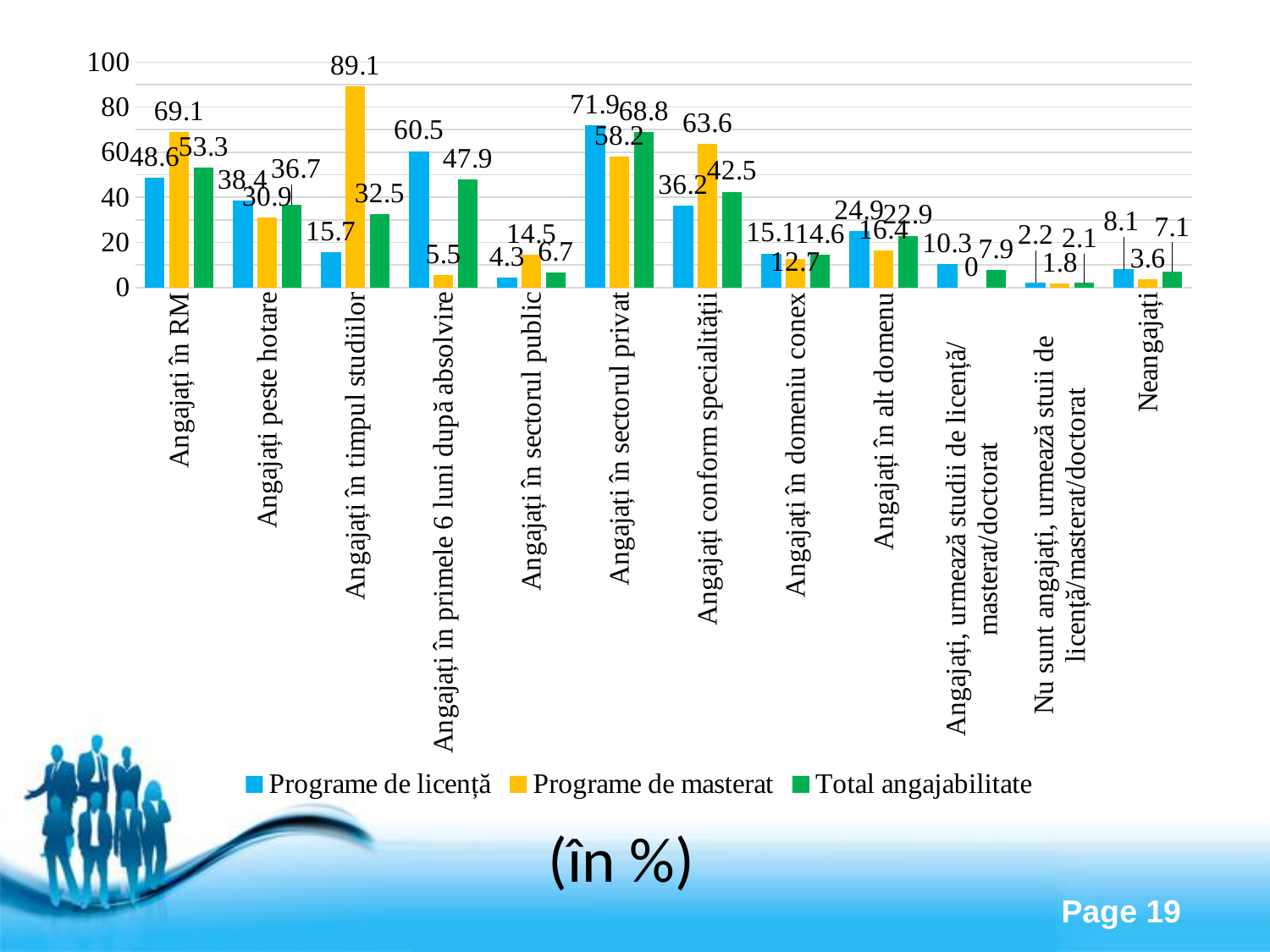
What kind of chart is shown on the slide? Bar chart Which category has the lowest value for Total angajabilitate? Nu sunt angajați, urmează stuii de licență/masterat/doctorat What is the value for Programe de licență in the category Angajați în sectorul privat? 71.9 What is the value for Programe de masterat in the category Angajați, urmează studii de licență/masterat/doctorat? 0 What is the value for Total angajabilitate in the category Angajați în RM? 53.3 What is the difference between Programe de masterat and Programe de licență in the category Angajați în RM? 20.5 Which category has the highest value for Programe de licență? Angajați în sectorul privat How many series does the legend list? 3 Which is larger in the category Angajați în primele 6 luni după absolvire: Programe de licență or Programe de masterat? Programe de licență What is the value for Programe de masterat in the category Angajați în timpul studiilor? 89.1 Which colour represents Total angajabilitate in the legend? Green How many categories are shown on the x axis? 12